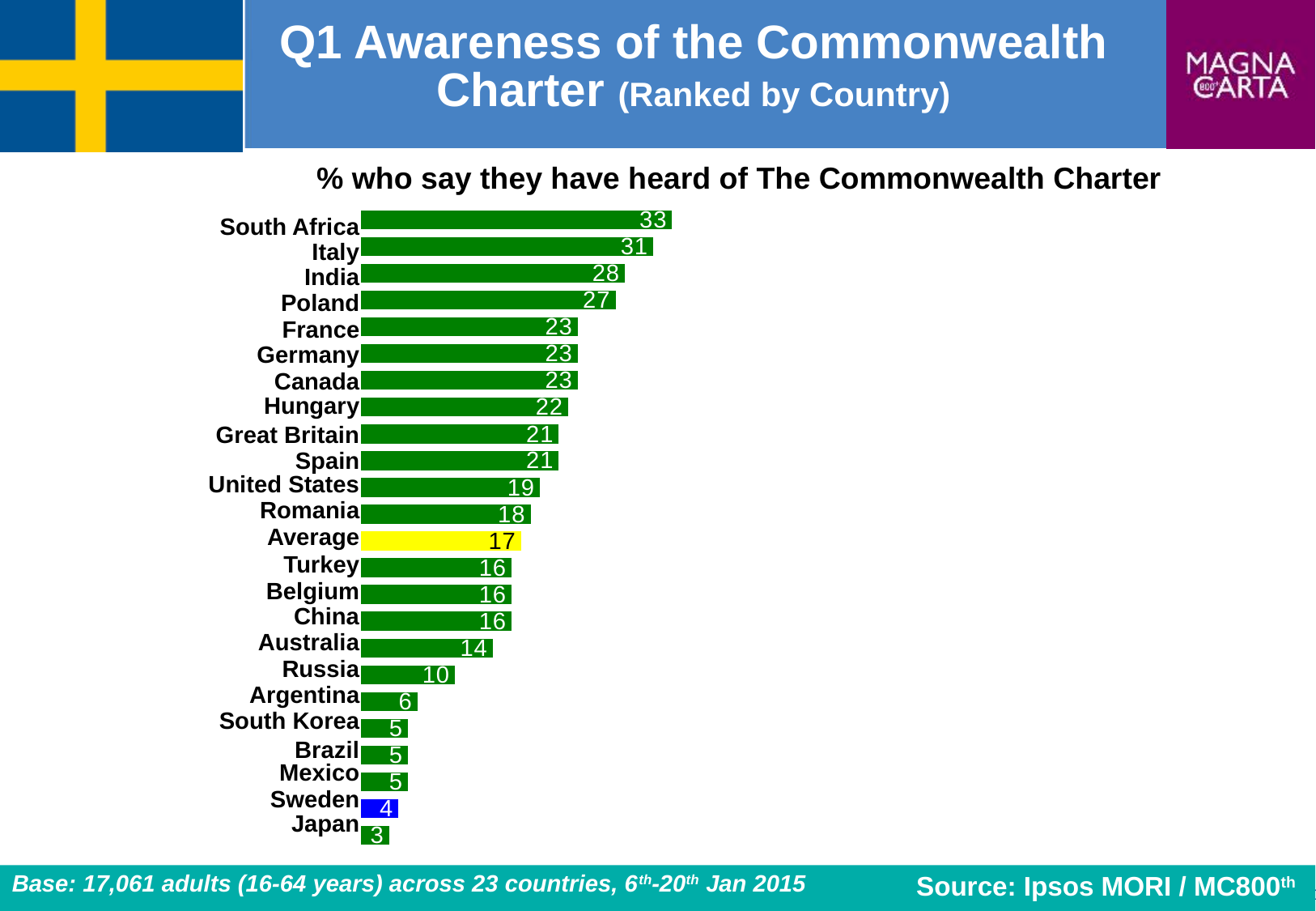
How many bars are plotted on the chart, including the Average bar? 24 Which country has the lowest awareness of The Commonwealth Charter? Japan Which has a higher value, Russia or Australia? Australia Which bar is coloured blue on the chart? Sweden What is the value shown for Sweden? 4 What is the value shown for Great Britain? 21 What is the value shown for the Average bar? 17 What is the difference between the values for South Africa and Japan? 30 What percentage of people in South Africa say they have heard of The Commonwealth Charter? 33 Which country has the highest awareness of The Commonwealth Charter? South Africa What kind of chart is shown on the slide? Bar chart What is the difference between the values for Italy and India? 3